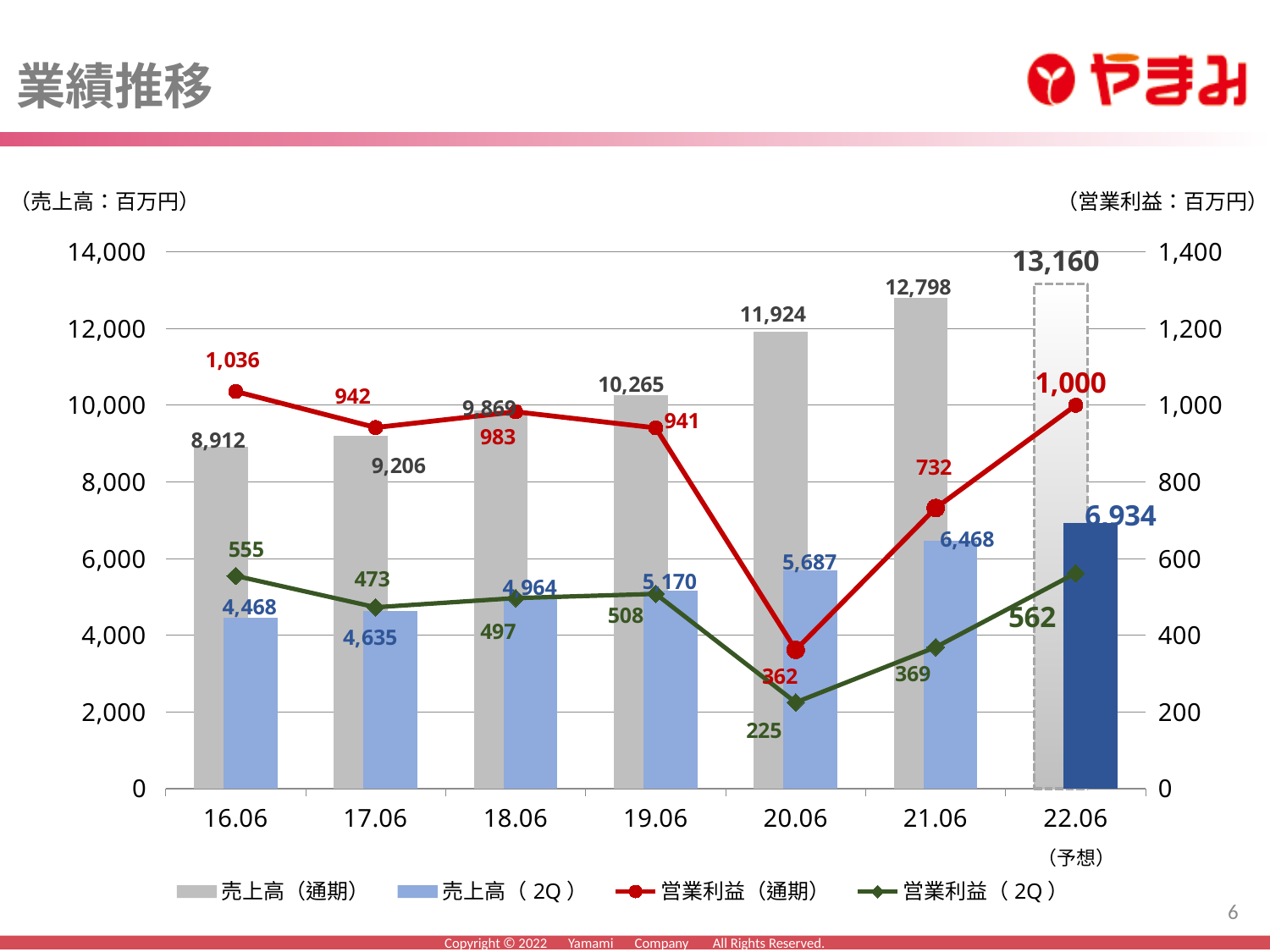
In which period is 営業利益（通期） lowest? 20.06 What is the difference between 売上高（通期） for 22.06（予想） and 21.06? 362 How many series does the legend list? 4 What is the value of 営業利益（通期） for 16.06? 1,036 What is the value of 売上高（通期） for 21.06? 12,798 What is the value of 営業利益（2Q） for 22.06（予想）? 562 In which period is 売上高（通期） highest? 22.06（予想） What is the title of the slide? 業績推移 How many periods are shown on the x axis? 7 Which is larger, 営業利益（2Q） for 16.06 or for 17.06? 16.06 Does 売上高（2Q） rise or fall from 16.06 to 22.06（予想）? rise What is the value of 売上高（2Q） for 20.06? 5,687